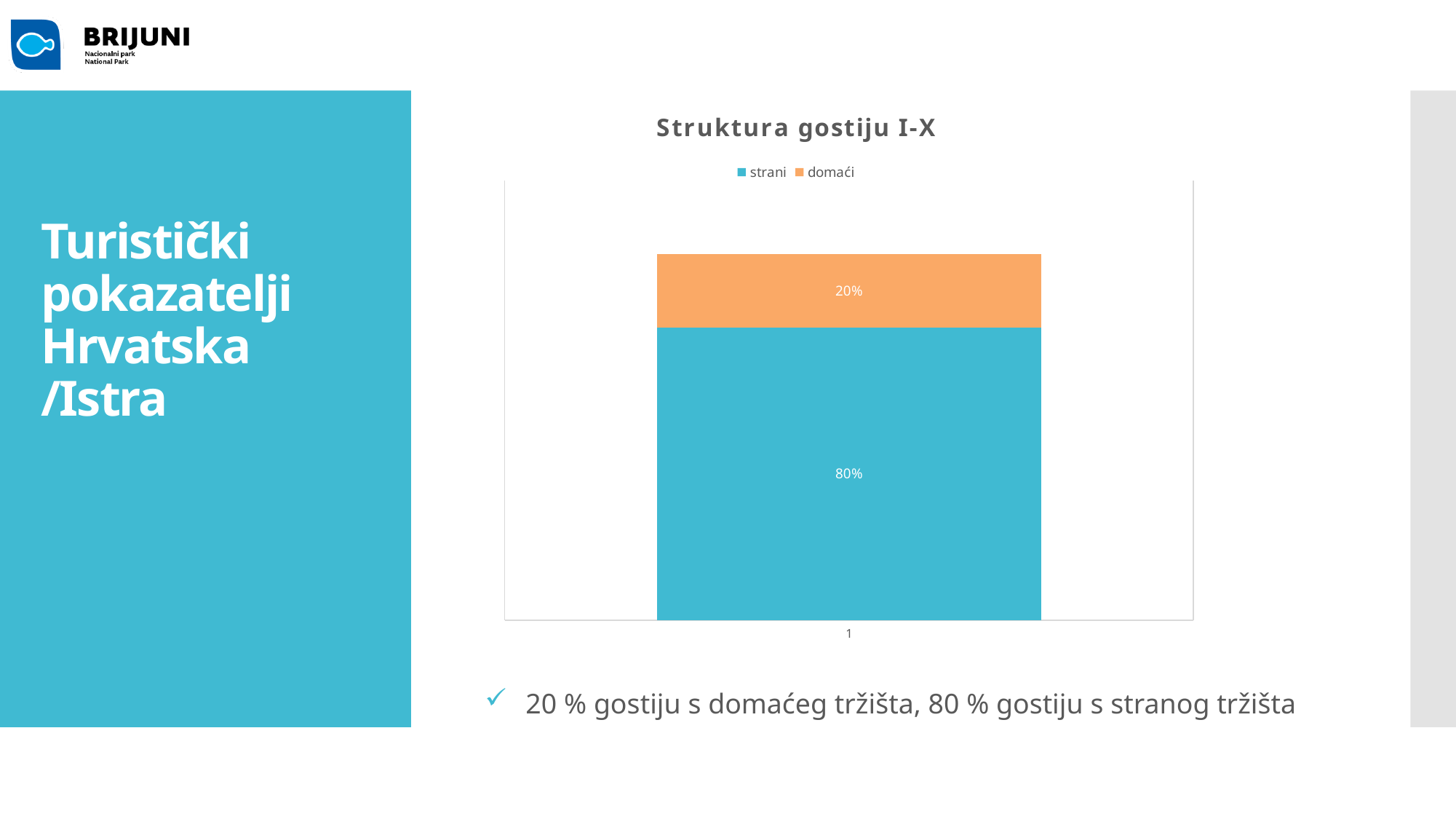
What is the total of the stacked bar? 100% How many bars are plotted in the chart? 1 What is the value for the 'domaći' series in the chart? 20% Which series has the largest value in the chart? strani Which series has the larger value, 'strani' or 'domaći'? strani What is the difference between the 'strani' and 'domaći' values? 60% What kind of chart is shown on the slide? Stacked bar chart What is the value for the 'strani' series in the chart? 80% How many series does the legend list? 2 What is the title of the chart? Struktura gostiju I-X Which colour represents the 'domaći' series in the chart? Orange Which series has the smallest value in the chart? domaći